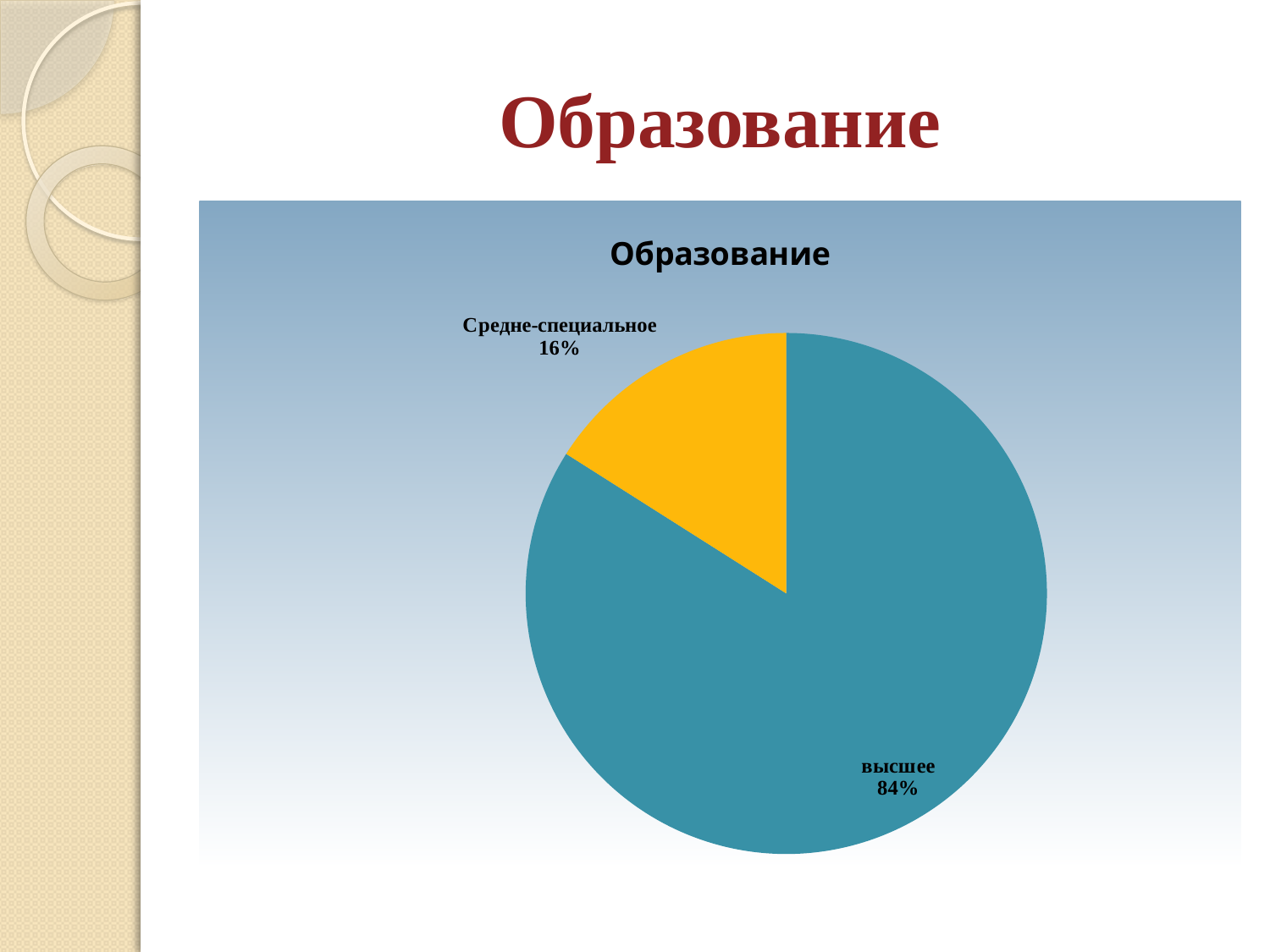
What is the total of the two slice percentages shown? 100% What share of the pie does the "высшее" slice represent? 84% What share of the pie does the "Средне-специальное" slice represent? 16% What is the difference in percentage points between the "высшее" and "Средне-специальное" slices? 68 Which is larger, the "высшее" slice or the "Средне-специальное" slice? высшее What type of chart is shown on the slide? pie chart How many slices does the pie chart have? 2 Which category has the largest slice of the pie? высшее Which category has the smallest slice of the pie? Средне-специальное What is the title of the chart? Образование What colour is the "Средне-специальное" slice? yellow